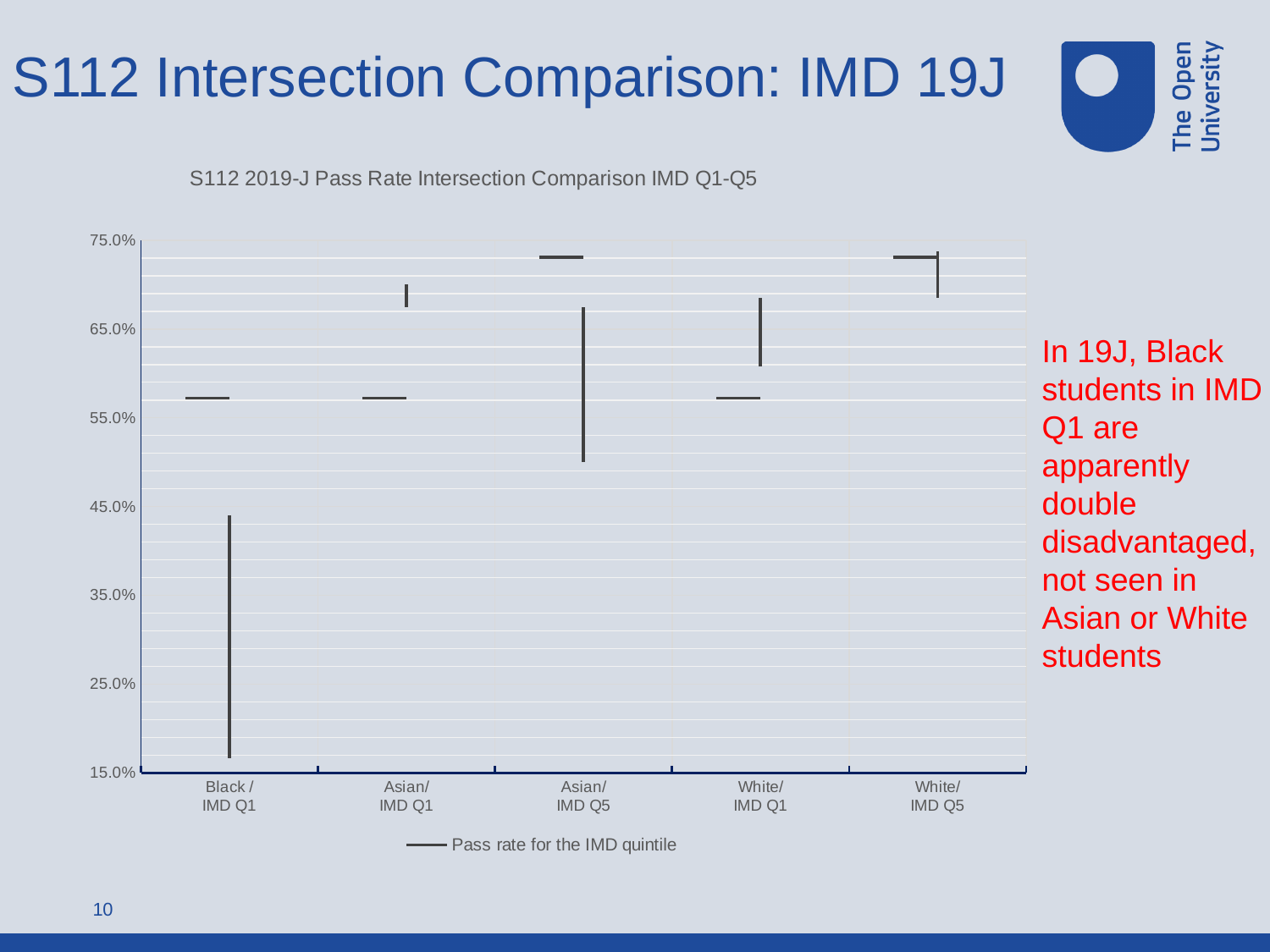
Is the lowest point of the vertical bar for Black / IMD Q1 greater or less than 25.0%? less How many series does the chart's legend list? 1 What is the title of the chart? S112 2019-J Pass Rate Intersection Comparison IMD Q1-Q5 Is the lowest point of the vertical bar for Asian/ IMD Q5 greater or less than 45.0%? greater Which has the higher pass rate for the IMD quintile marker: Asian/ IMD Q5 or Black / IMD Q1? Asian/ IMD Q5 Is the pass rate for the IMD quintile marker for White/ IMD Q5 greater or less than 65.0%? greater How many categories are shown on the x axis of the chart? 5 What is the legend entry shown below the chart? Pass rate for the IMD quintile Which has the higher pass rate for the IMD quintile marker: White/ IMD Q5 or White/ IMD Q1? White/ IMD Q5